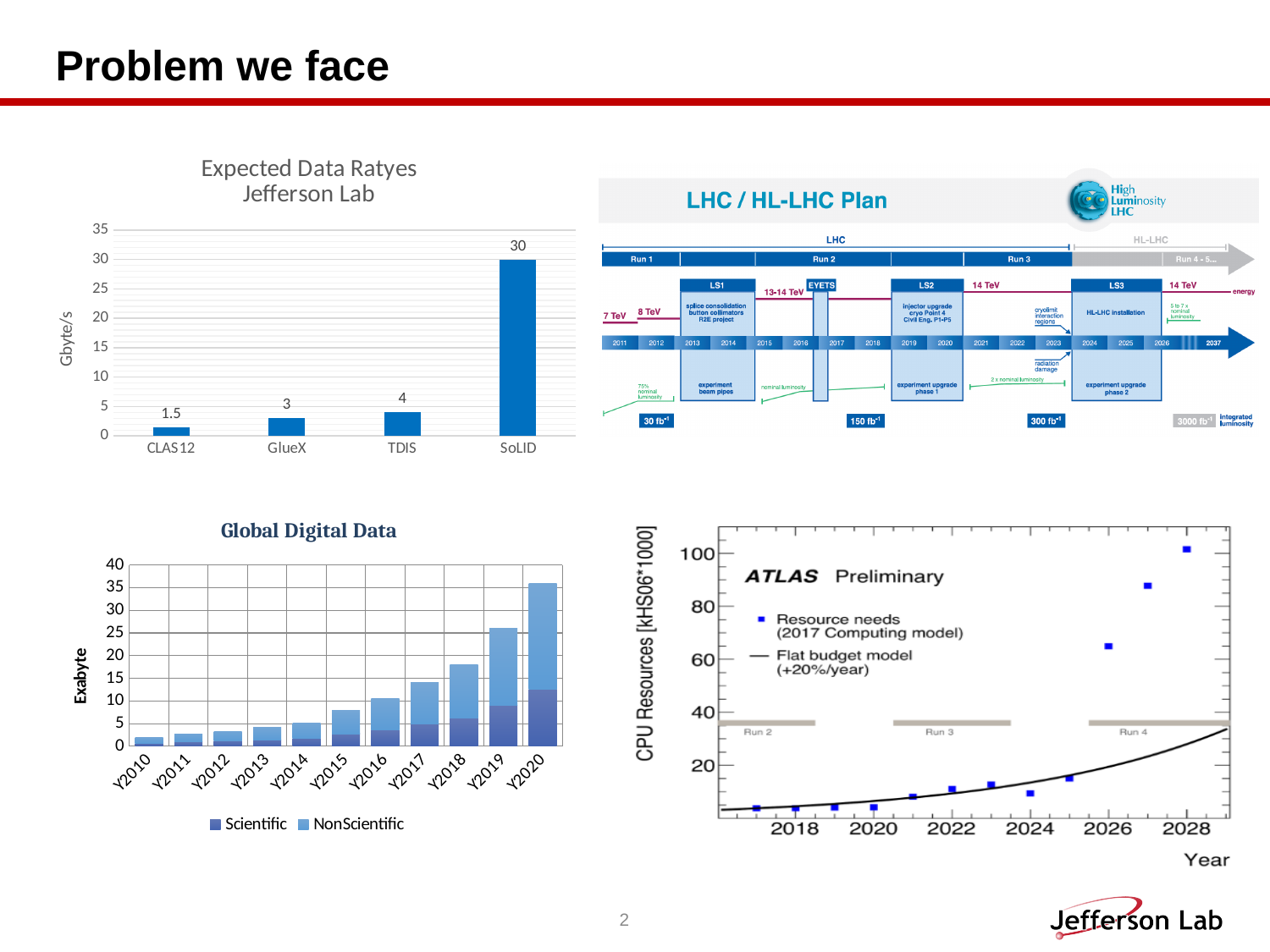
How many years are shown on the x axis of the 'Global Digital Data' chart? 11 In the 'Global Digital Data' chart, do the total bar heights rise or fall from Y2010 to Y2020? rise In the 'Expected Data Ratyes Jefferson Lab' chart, which category has the highest value? SoLID What kind of chart is the 'ATLAS Preliminary' chart in the bottom right? scatter plot In the 'Expected Data Ratyes Jefferson Lab' chart, which is larger, the value for GlueX or the value for TDIS? TDIS In the 'Expected Data Ratyes Jefferson Lab' chart, which category has the lowest value? CLAS12 In the 'Expected Data Ratyes Jefferson Lab' chart, what is the value for SoLID? 30 In the 'Expected Data Ratyes Jefferson Lab' chart, what is the value for CLAS12? 1.5 How many series does the legend of the 'Global Digital Data' chart list? 2 In the 'Global Digital Data' chart, is the total for Y2018 greater or less than 15? greater In the 'Expected Data Ratyes Jefferson Lab' chart, what is the label on the vertical axis? Gbyte/s In the 'Expected Data Ratyes Jefferson Lab' chart, what is the difference between the values for SoLID and TDIS? 26